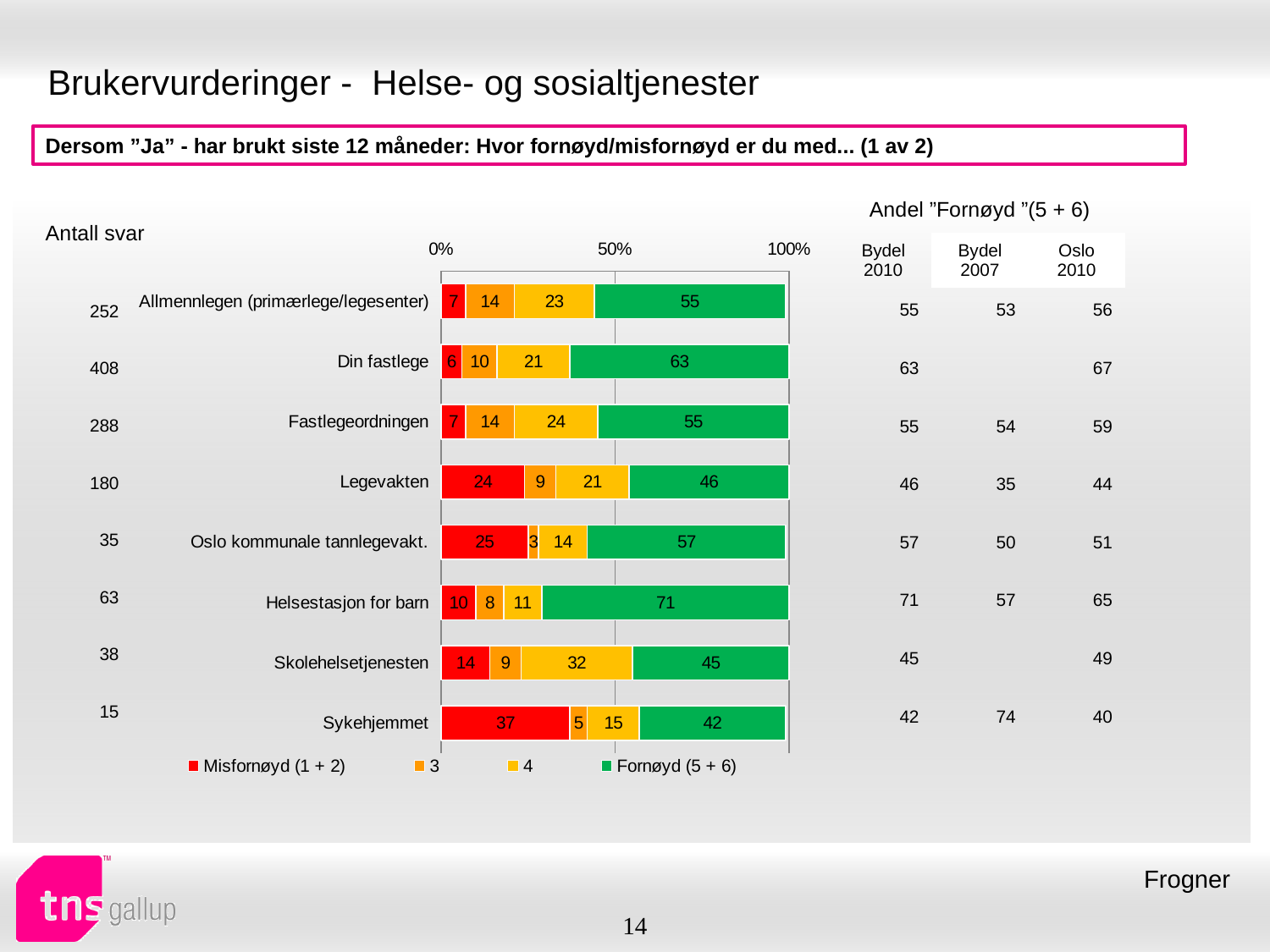
What is the Misfornøyd (1 + 2) value for Sykehjemmet? 37 What is the value of series 4 for Skolehelsetjenesten? 32 How many categories (services) are plotted in the chart? 8 What is the difference between the Fornøyd (5 + 6) values for Din fastlege and Legevakten? 17 What is the Fornøyd (5 + 6) value for Helsestasjon for barn? 71 What kind of chart is shown on the slide? Stacked bar chart Which category has the highest Fornøyd (5 + 6) value? Helsestasjon for barn What is the first entry in the chart legend? Misfornøyd (1 + 2) Which has a larger Misfornøyd (1 + 2) value, Legevakten or Oslo kommunale tannlegevakt.? Oslo kommunale tannlegevakt. Which category has the lowest Fornøyd (5 + 6) value? Sykehjemmet What is the total of the stacked bar for Allmennlegen (primærlege/legesenter)? 99 How many series does the chart legend list? 4